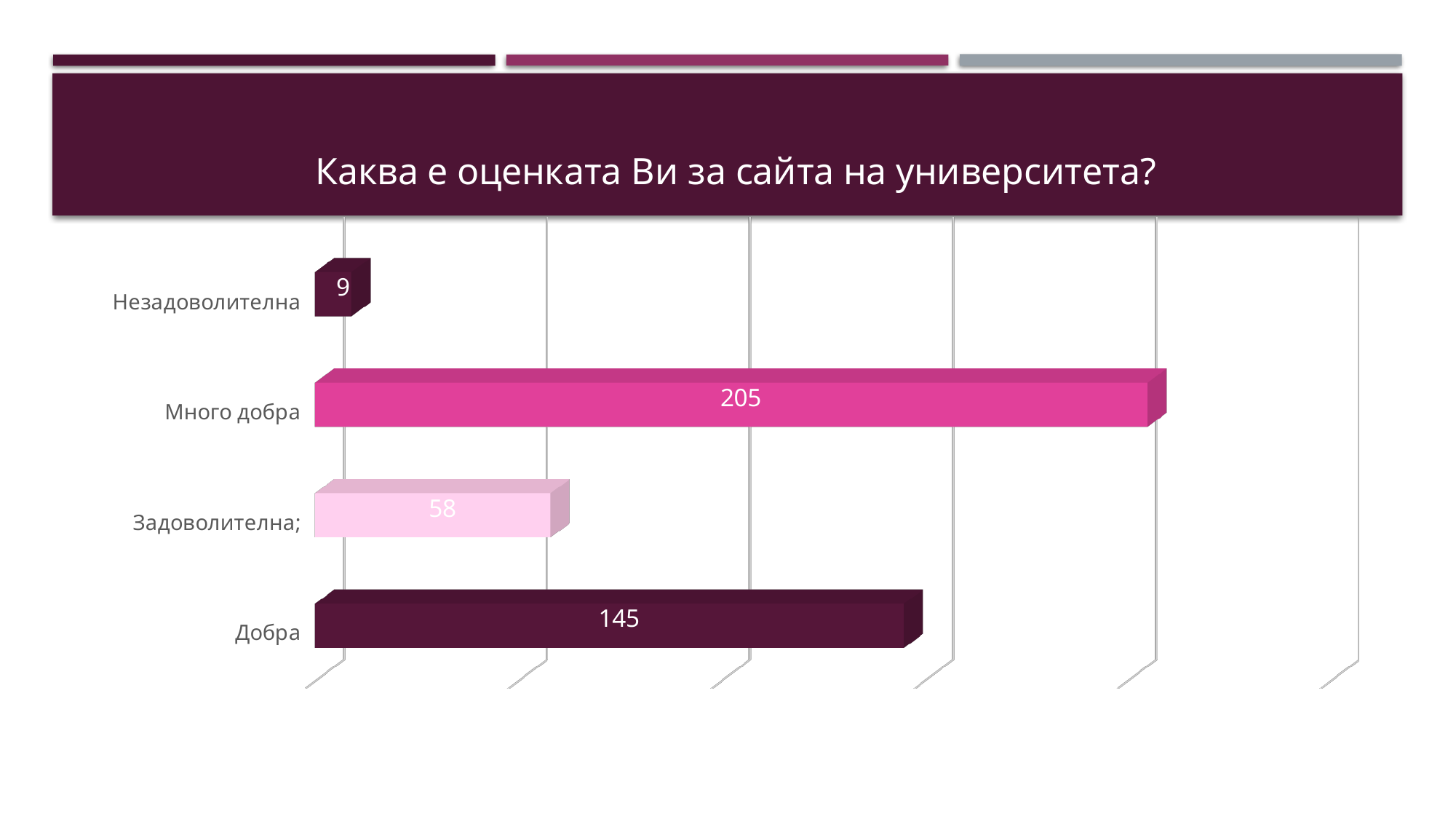
Which category has the lowest value? Незадоволителна Which category has the highest value? Много добра What is the title of the slide? Каква е оценката Ви за сайта на университета? Which is larger, the value for Добра or the value for Задоволителна? Добра What is the value for Много добра? 205 What is the difference between the values for Задоволителна and Незадоволителна? 49 What is the difference between the values for Много добра and Добра? 60 What is the value for Незадоволителна? 9 What is the value for Добра? 145 What is the value for Задоволителна? 58 How many categories are shown in the chart? 4 What kind of chart is shown on the slide? Bar chart